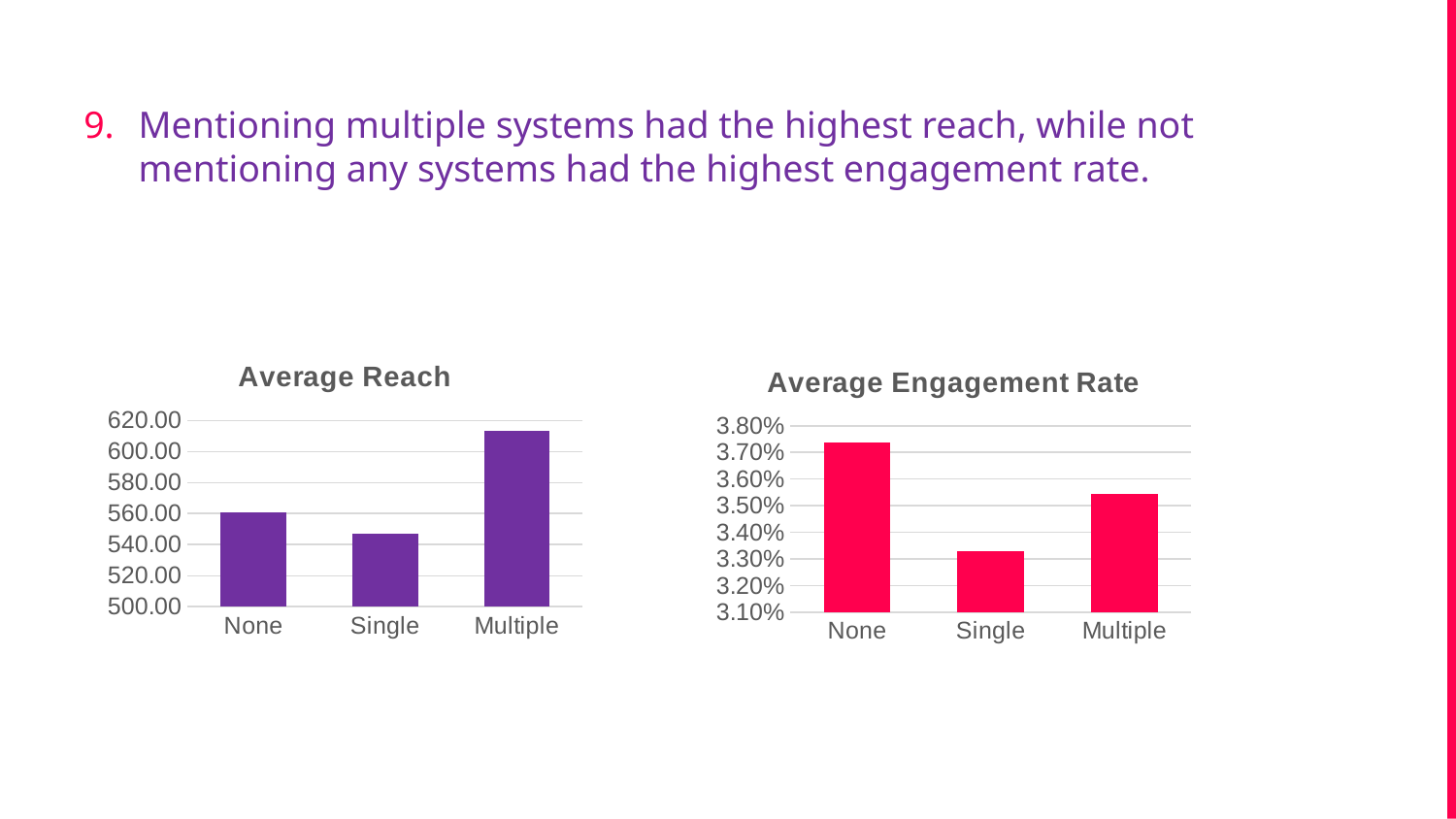
In the Average Engagement Rate chart, which category has the lowest value? Single In the Average Engagement Rate chart, is the value for Multiple greater or less than 3.40%? greater In the Average Reach chart, is the value for Single greater or less than 560.00? less In the Average Reach chart, is the value for Multiple greater or less than 600.00? greater How many categories are shown in the Average Reach chart? 3 In the Average Reach chart, which category has the lowest value? Single In the Average Engagement Rate chart, which category has the highest value? None In the Average Engagement Rate chart, which is larger, the value for Multiple or the value for Single? Multiple What type of chart is the Average Engagement Rate chart? Bar chart In the Average Reach chart, which category has the highest value? Multiple